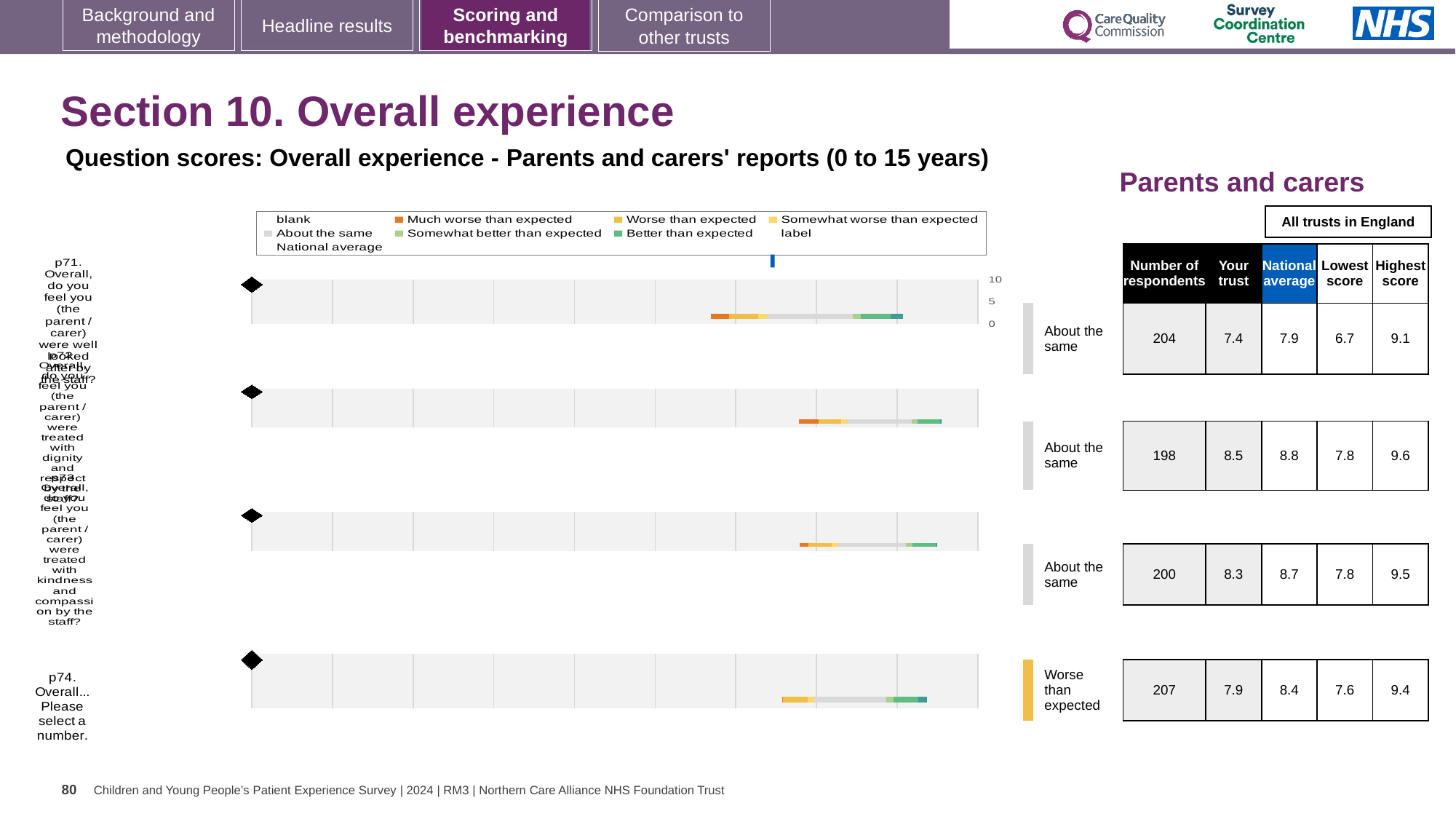
For question p71, what is the difference between the highest score and the lowest score? 2.4 Which has the higher 'Your trust' score: question p71 or question p74? p74 What benchmark category is shown for question p74 (Overall... Please select a number)? Worse than expected What is the highest score across all trusts in England for question p71? 9.1 Which question row has the highest number of respondents? p74. Overall... Please select a number. For question p74, what is the difference between the national average and the 'Your trust' score? 0.5 Which question row has the lowest 'Your trust' score? p71. Overall, do you feel you were well looked after by the staff? How many respondents answered question p74 (Overall... Please select a number)? 207 What is the national average score for question p74 (Overall... Please select a number)? 8.4 What is the 'Your trust' score for question p71 (Overall, do you feel you were well looked after by the staff?)? 7.4 How many entries does the chart legend list? 9 How many question rows are plotted in the chart? 4